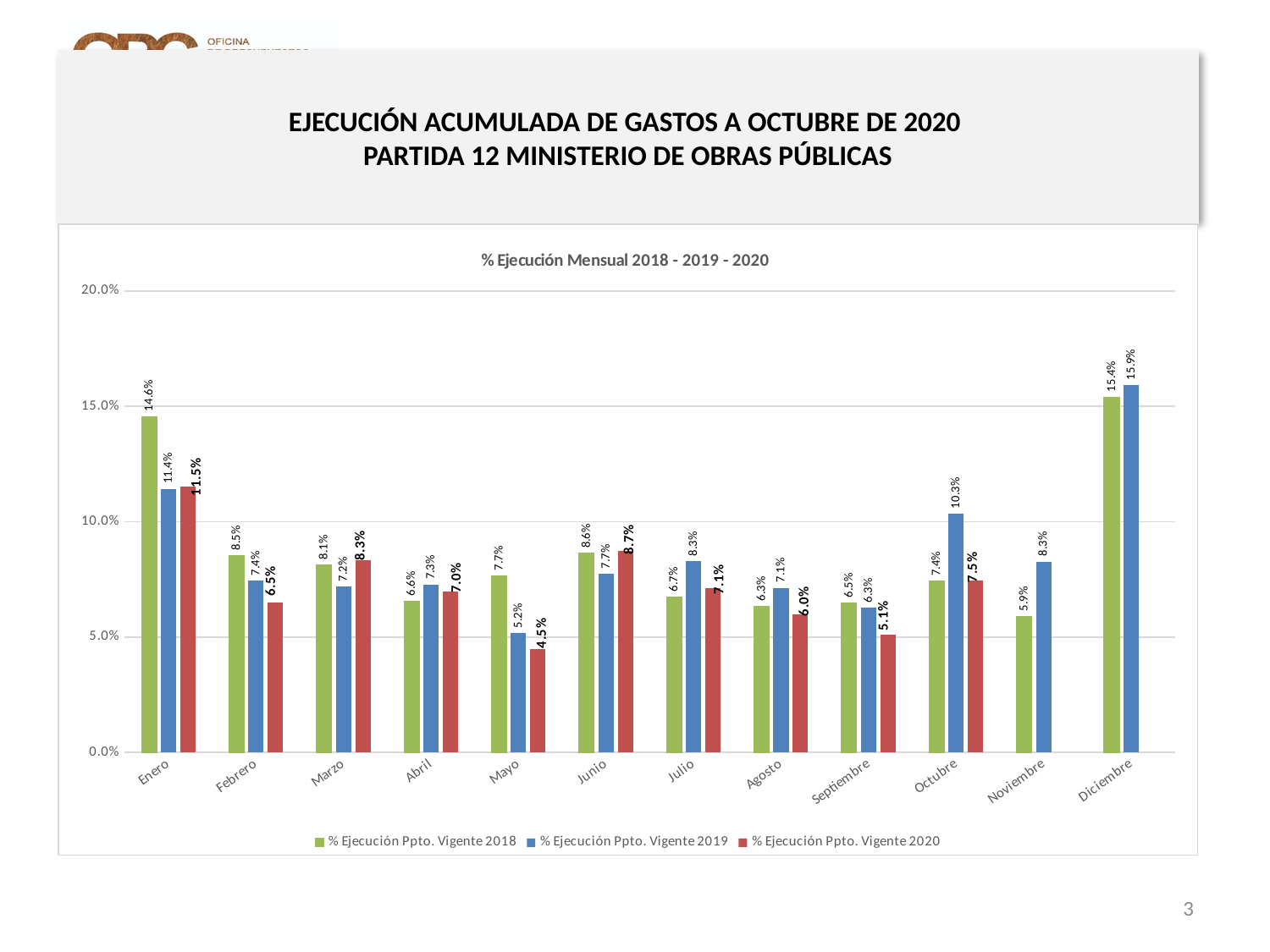
Is the value for % Ejecución Ppto. Vigente 2019 in Diciembre greater or less than 15.0%? greater What is the value for % Ejecución Ppto. Vigente 2020 in Enero? 11.5% What kind of chart is shown on the slide? Bar chart Which month has the lowest value for % Ejecución Ppto. Vigente 2020? Mayo What is the value for % Ejecución Ppto. Vigente 2018 in Diciembre? 15.4% What is the value for % Ejecución Ppto. Vigente 2019 in Octubre? 10.3% How many series does the legend list? 3 How many months are shown on the x axis? 12 What is the difference between the 2019 and 2020 values in Mayo? 0.7% What is the title of the chart? % Ejecución Mensual 2018 - 2019 - 2020 Which is larger in Octubre: the 2019 value or the 2018 value? 2019 Which month has the highest value for % Ejecución Ppto. Vigente 2020? Enero